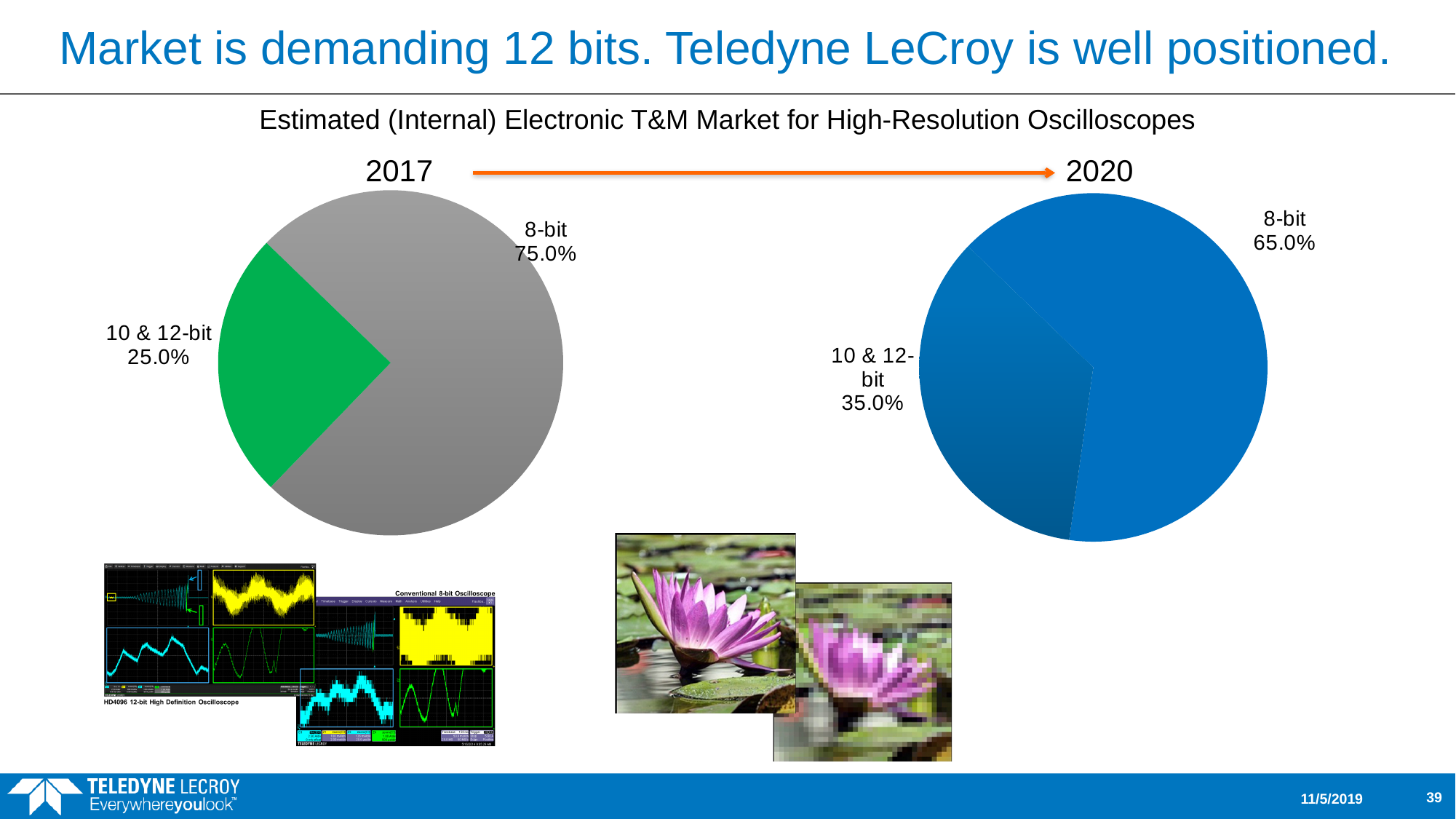
In the 2017 pie chart, what share does the 10 & 12-bit slice have? 25.0% What colour is the 10 & 12-bit slice in the 2017 pie chart? Green In the 2020 pie chart, what share does the 10 & 12-bit slice have? 35.0% In the 2017 pie chart, what is the difference in percentage points between the 8-bit and 10 & 12-bit shares? 50.0 percentage points What type of chart is used to show the 2020 market split? Pie chart How many slices does the 2017 pie chart have? 2 In the 2017 pie chart, what share does the 8-bit slice have? 75.0% In the 2020 pie chart, what is the difference in percentage points between the 8-bit and 10 & 12-bit shares? 30.0 percentage points Is the 10 & 12-bit share larger in the 2017 pie chart or the 2020 pie chart? 2020 In the 2020 pie chart, which category has the smallest share? 10 & 12-bit In the 2017 pie chart, which category has the largest share? 8-bit In the 2020 pie chart, what share does the 8-bit slice have? 65.0%